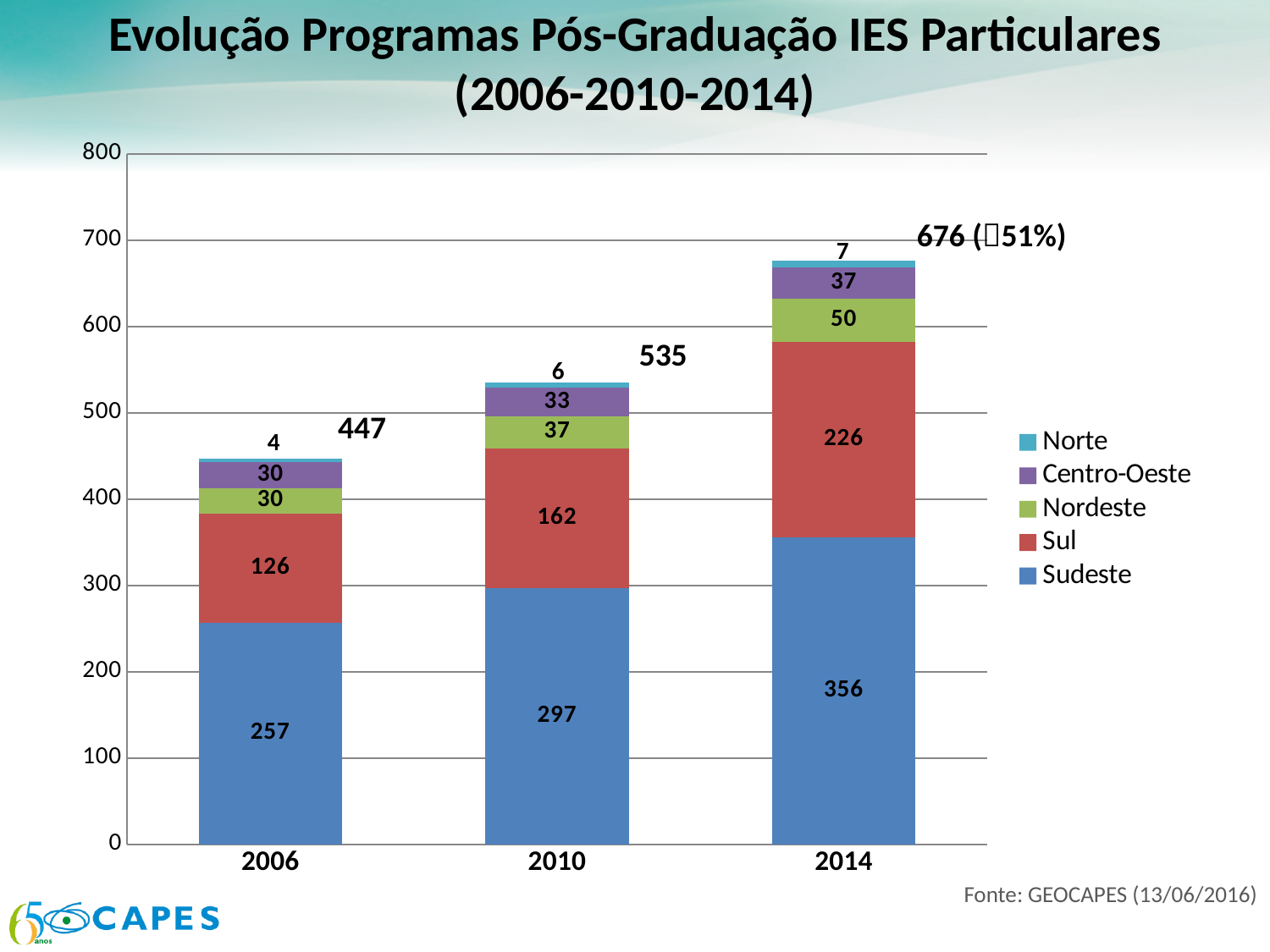
What is the difference between the Sudeste values for 2014 and 2006? 99 What is the value for Sudeste in 2014? 356 Which year has the lowest value for Centro-Oeste? 2006 What is the total of the stacked bar for 2010? 535 Which year has the highest value for Sul? 2014 What is the value for Sul in 2006? 126 How many series does the legend list? 5 What kind of chart is shown on the slide? Stacked bar chart Which is larger, the Sul value in 2010 or the Sul value in 2006? 2010 What is the total of the stacked bar for 2006? 447 What is the value for Norte in 2014? 7 What is the value for Nordeste in 2010? 37